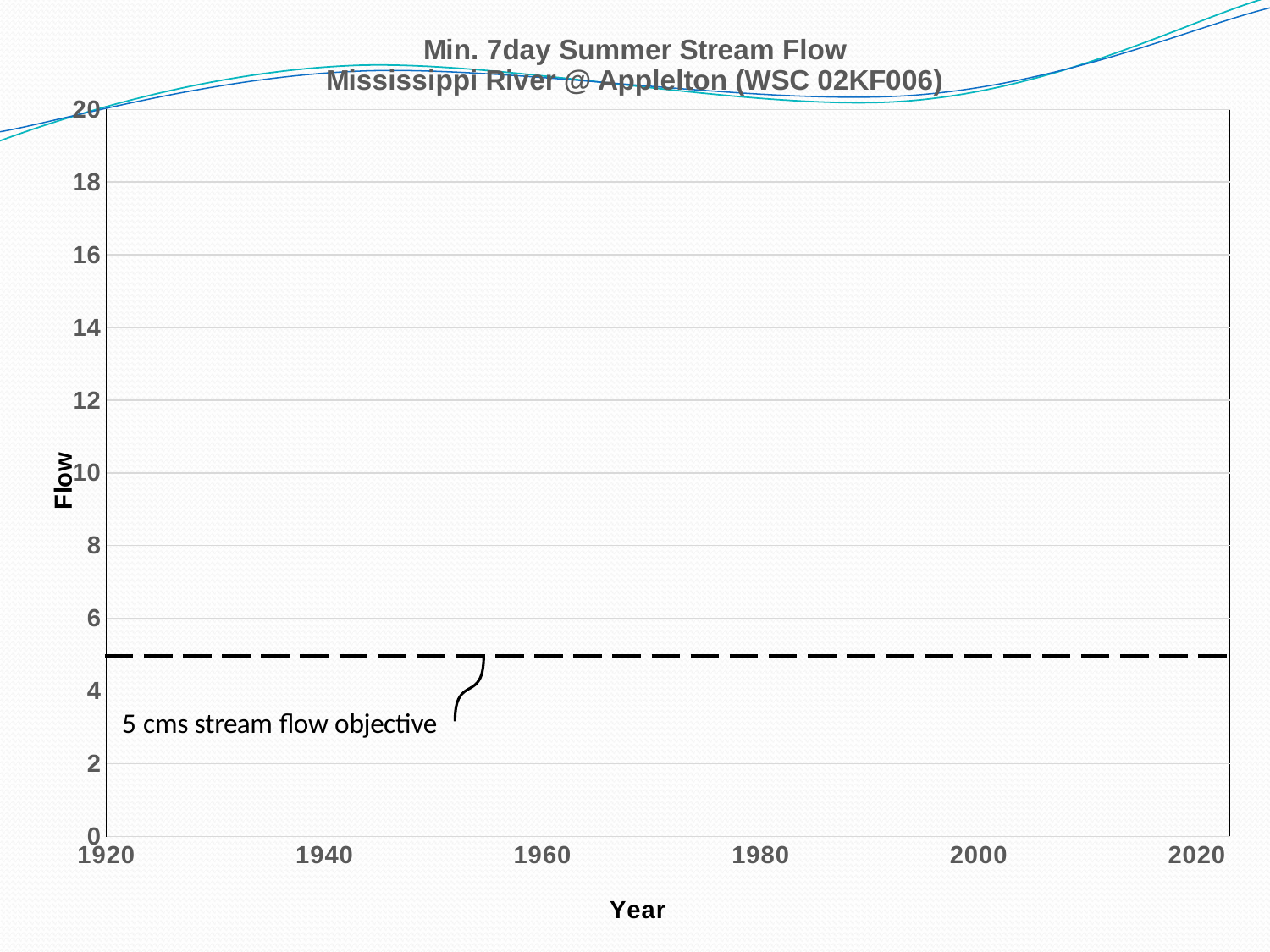
At what flow value is the dashed stream flow objective line drawn? 5 What is the title of the chart? Min. 7day Summer Stream Flow Mississippi River @ Applelton (WSC 02KF006) Is the dashed stream flow objective line greater or less than 4 on the Flow axis? greater What stream flow objective is marked by the dashed horizontal line on the chart? 5 cms What is the highest value shown on the Flow axis? 20 What is the first year shown on the x axis of the chart? 1920 Is the dashed stream flow objective line greater or less than 6 on the Flow axis? less What is the label on the y axis of the chart? Flow How many year tick labels are shown along the x axis? 6 What is the last year shown on the x axis of the chart? 2020